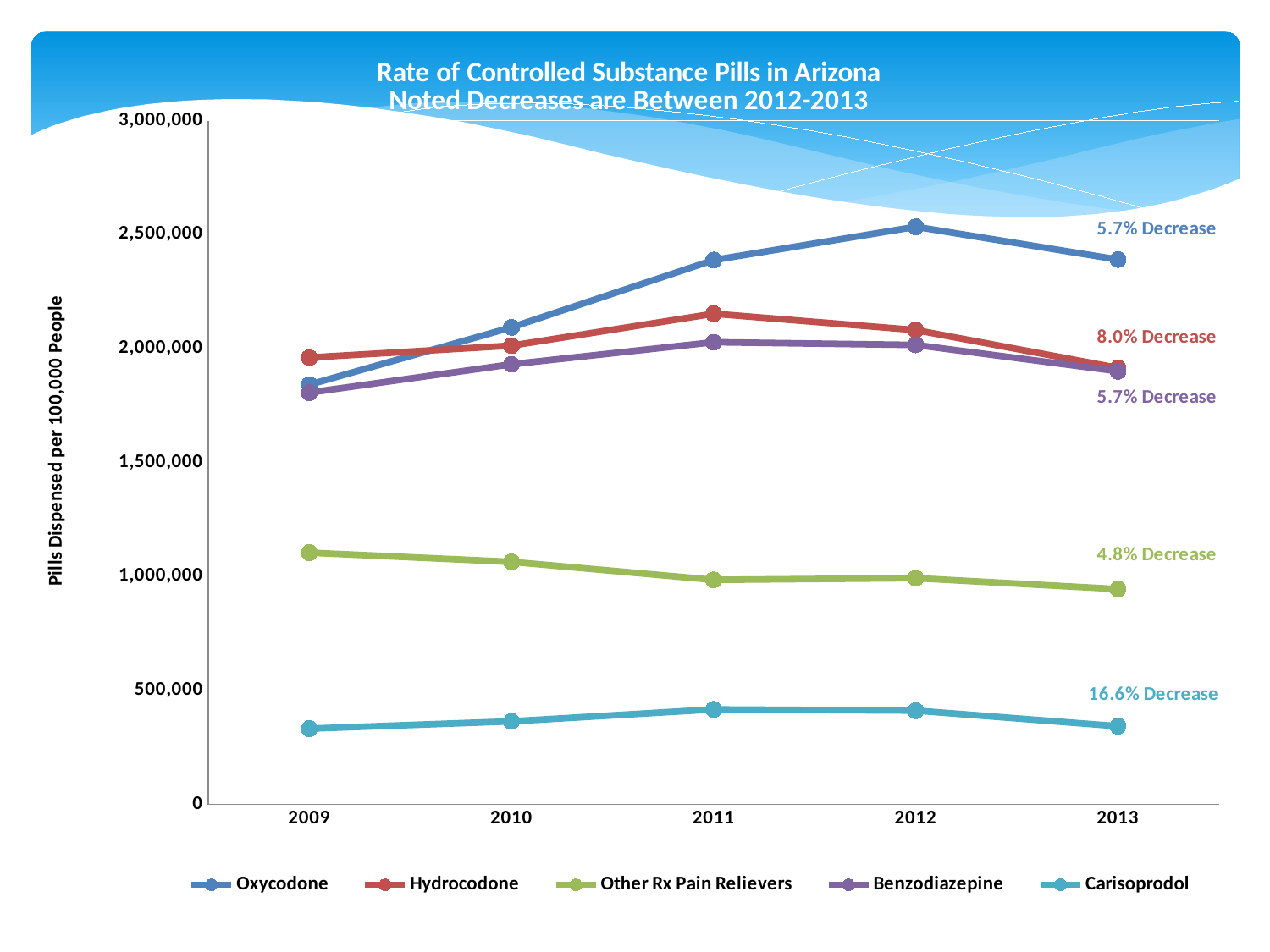
Is the value for Carisoprodol in 2013 greater or less than 500,000? less Which series has the largest noted percentage decrease between 2012 and 2013? Carisoprodol Is the value for Other Rx Pain Relievers in 2009 greater or less than 1,000,000? greater Which series has the lowest value in 2013? Carisoprodol How many series does the legend list? 5 How many years are shown on the x axis? 5 What kind of chart is shown on the slide? line chart In 2011, which is higher: Hydrocodone or Benzodiazepine? Hydrocodone What percentage decrease is noted for Hydrocodone? 8.0% Decrease Do the values for Oxycodone rise or fall from 2009 to 2012? rise Is the value for Oxycodone in 2011 greater or less than 2,000,000? greater Which series has the highest value in 2013? Oxycodone